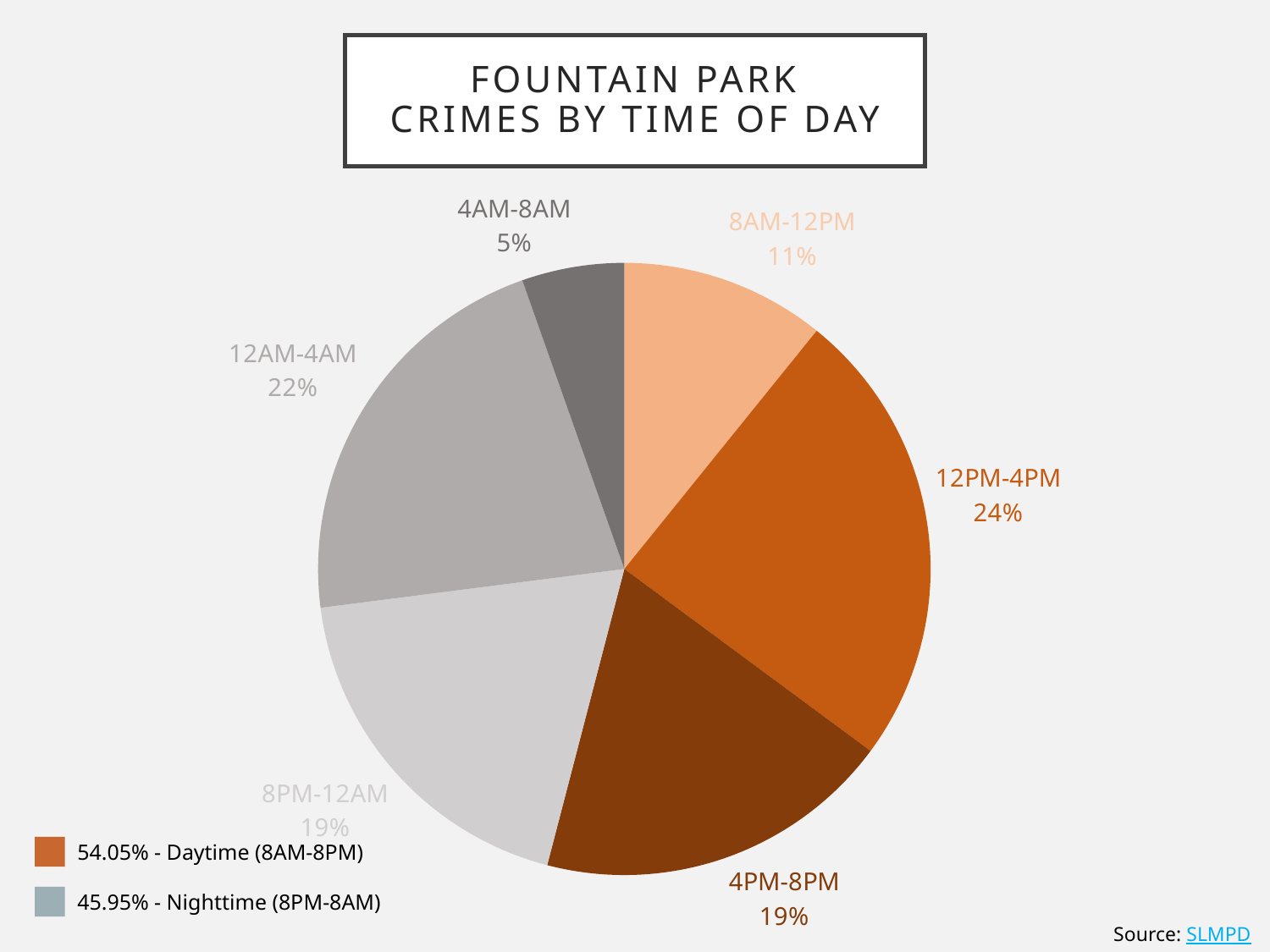
According to the legend, what percentage of crimes occurred during the daytime (8AM-8PM)? 54.05% How many time-of-day slices does the pie chart have? 6 What kind of chart is shown on the slide? Pie chart What share of crimes occurred between 12AM and 4AM? 22% Which time of day has the smallest share of crimes? 4AM-8AM What share of crimes occurred between 12PM and 4PM? 24% Which slice is larger, 12AM-4AM or 4PM-8PM? 12AM-4AM Which time of day has the largest share of crimes? 12PM-4PM What share of crimes occurred between 8AM and 12PM? 11% What is the difference in percentage points between the 12AM-4AM slice and the 8AM-12PM slice? 11 What share of crimes occurred between 4AM and 8AM? 5% What is the title of the chart? Fountain Park Crimes by Time of Day